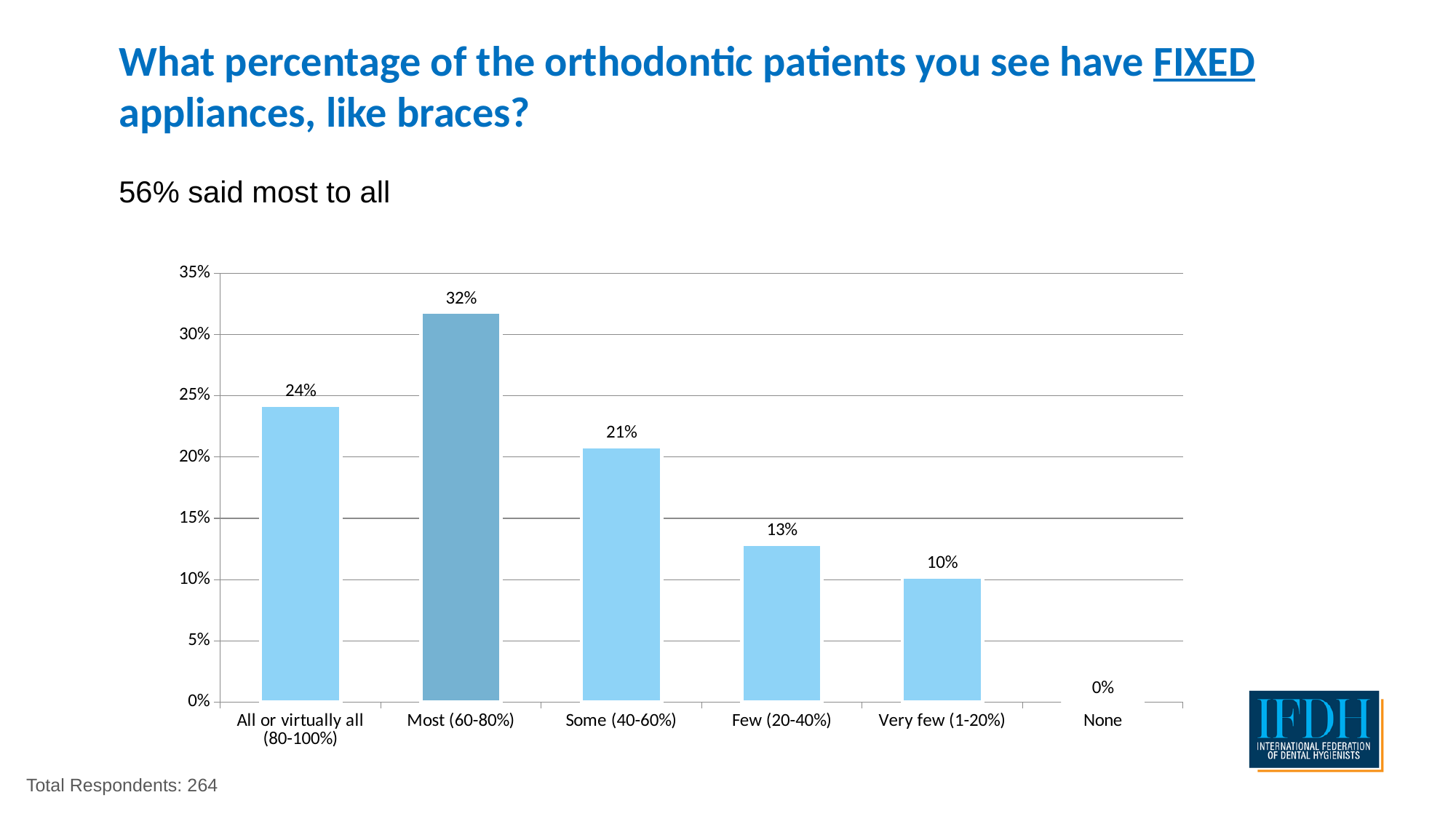
Which is larger, the value for "All or virtually all (80-100%)" or the value for "Some (40-60%)"? All or virtually all (80-100%) Which bar is shaded a darker blue than the others? Most (60-80%) How many categories are shown on the x axis? 6 Which category has the lowest value? None What is the difference between the values for "Most (60-80%)" and "Some (40-60%)"? 11% What value is shown for "All or virtually all (80-100%)"? 24% What value is shown for the "Few (20-40%)" category? 13% What kind of chart is shown on the slide? Bar chart Is the value for "Very few (1-20%)" greater or less than 15%? less Do the values rise or fall from "Most (60-80%)" to "None" along the x axis? Fall Which category has the highest value? Most (60-80%) What percentage of respondents said "Most (60-80%)" of their orthodontic patients have fixed appliances? 32%